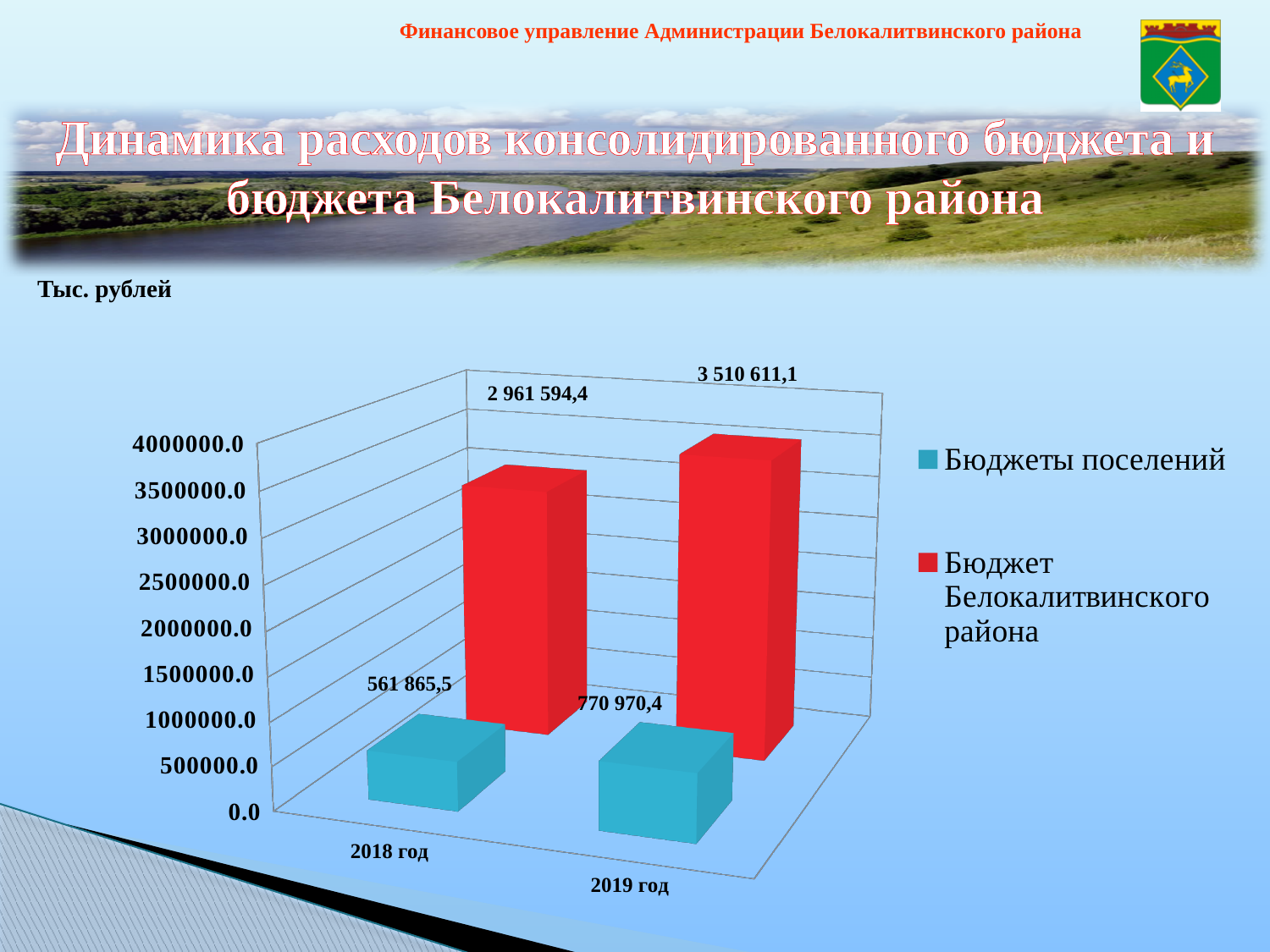
What is the value for Бюджет Белокалитвинского района in 2018 год? 2 961 594,4 What is the value for Бюджеты поселений in 2018 год? 561 865,5 Which year has the higher value for Бюджет Белокалитвинского района? 2019 год What is the value for Бюджеты поселений in 2019 год? 770 970,4 By how much did Бюджет Белокалитвинского района increase from 2018 год to 2019 год? 549 016,7 Which is larger in 2019 год: Бюджеты поселений or Бюджет Белокалитвинского района? Бюджет Белокалитвинского района How many series does the legend list? 2 What kind of chart is shown on the slide? Bar chart What is the difference between the Бюджеты поселений values for 2019 год and 2018 год? 209 104,9 What is the value for Бюджет Белокалитвинского района in 2019 год? 3 510 611,1 Which year has the lower value for Бюджеты поселений? 2018 год Is the value for Бюджет Белокалитвинского района in 2018 год greater or less than 2500000.0? greater